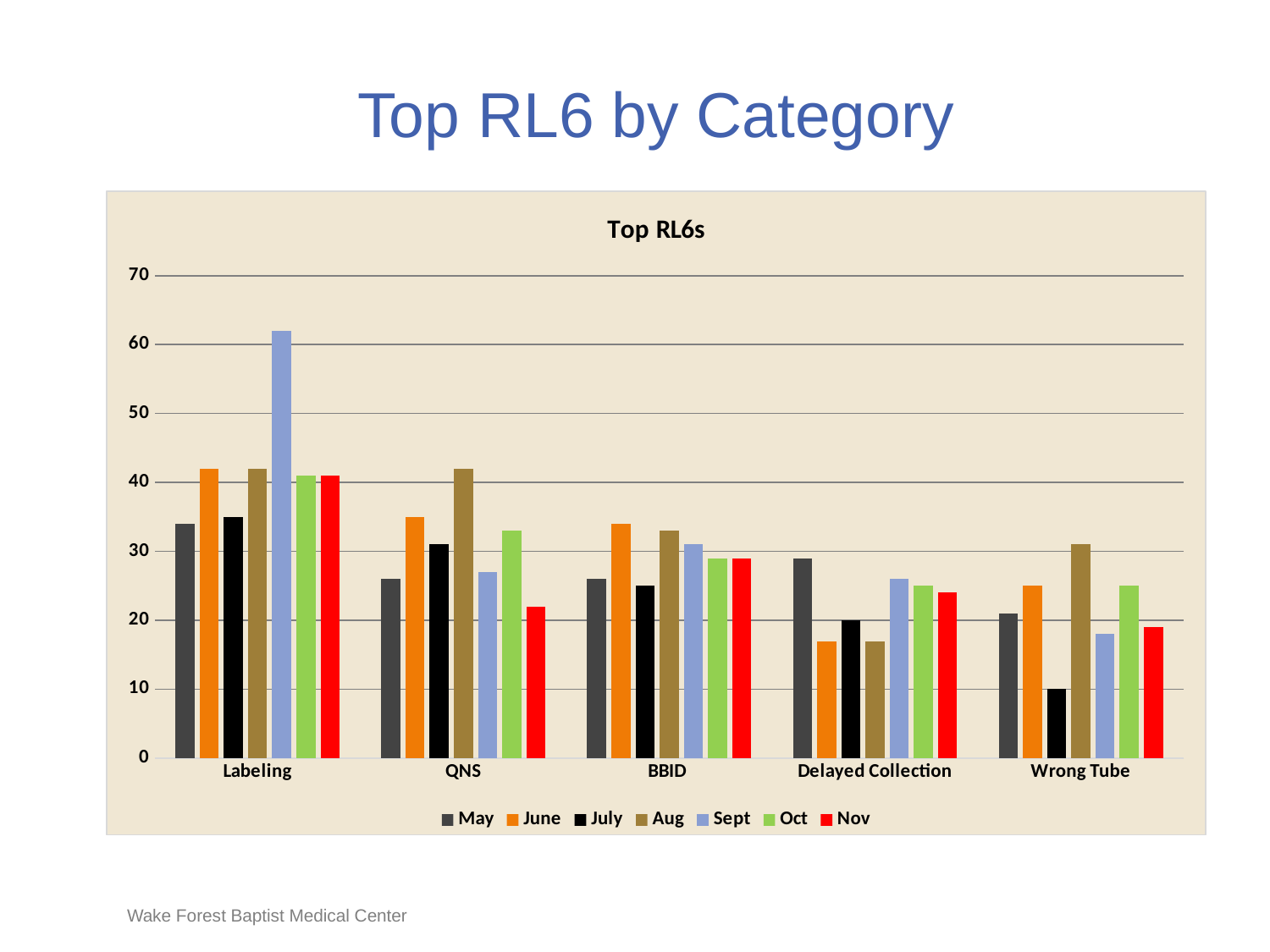
Is the value for Nov in the QNS category greater or less than 30? less Which is larger in the Delayed Collection category, the value for May or the value for June? May Is the value for Sept in the Labeling category greater or less than 60? greater Which month has the lowest value in the Wrong Tube category? July How many series does the legend list? 7 What type of chart is shown on the slide? bar chart Which month has the highest value in the Labeling category? Sept Which is larger in the BBID category, the value for June or the value for July? June What is the title shown inside the chart area? Top RL6s Which category contains the tallest bar in the chart? Labeling How many categories are shown along the x axis? 5